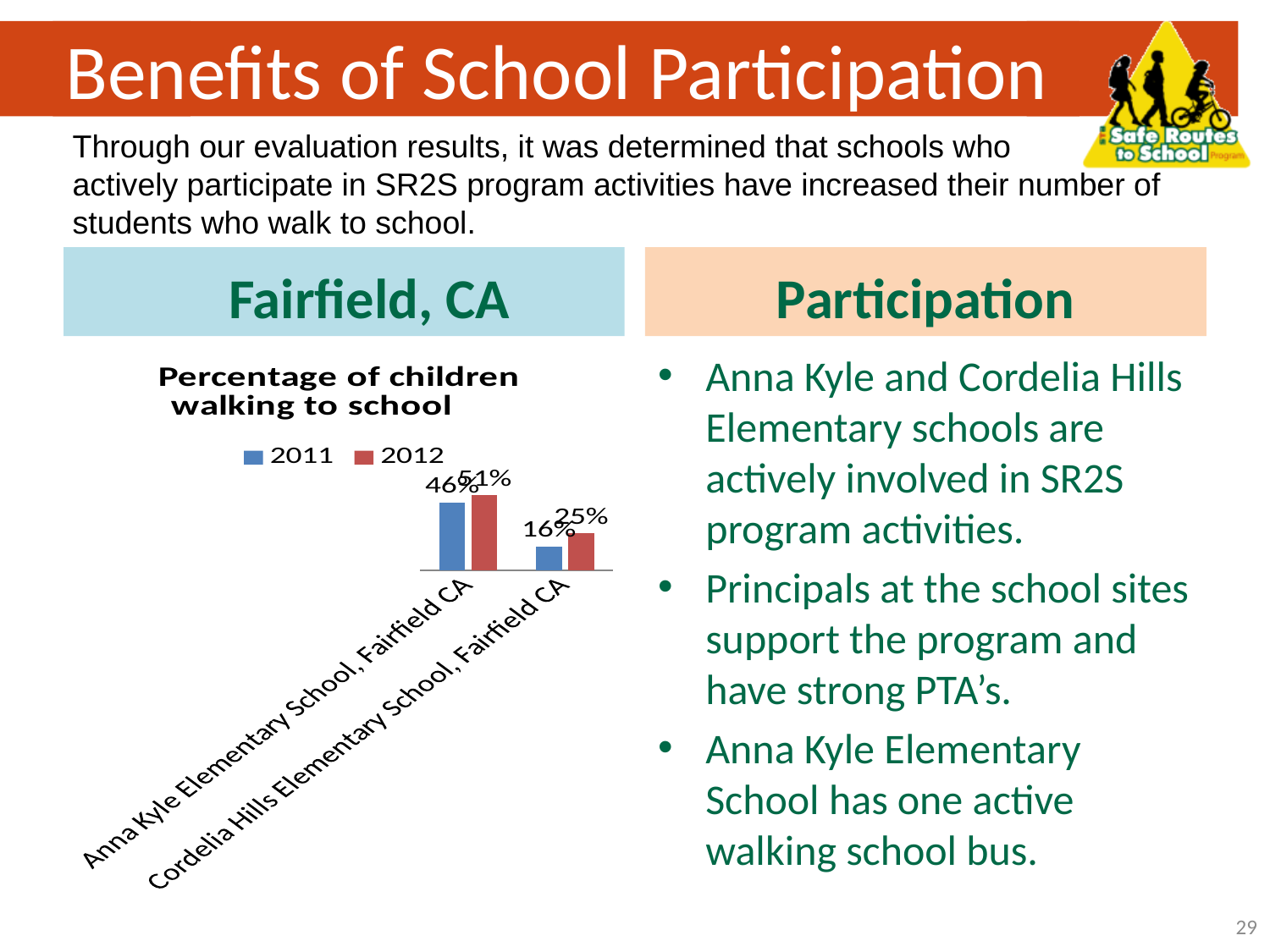
What was the percentage of children walking to school at Cordelia Hills Elementary School in 2011? 16% Which school had the highest percentage of children walking to school in 2012? Anna Kyle Elementary School, Fairfield CA What was the percentage of children walking to school at Anna Kyle Elementary School in 2012? 51% By how many percentage points did the share of children walking to school at Cordelia Hills Elementary School increase from 2011 to 2012? 9 Which series does the legend list in the chart? 2011 and 2012 What was the percentage of children walking to school at Anna Kyle Elementary School in 2011? 46% How many series does the chart's legend list? 2 Which is larger: the 2011 value for Anna Kyle Elementary School or the 2012 value for Cordelia Hills Elementary School? the 2011 value for Anna Kyle Elementary School What is the title of the chart? Percentage of children walking to school How many schools (categories) are shown in the chart? 2 What was the percentage of children walking to school at Cordelia Hills Elementary School in 2012? 25% What kind of chart is shown on the slide? bar chart